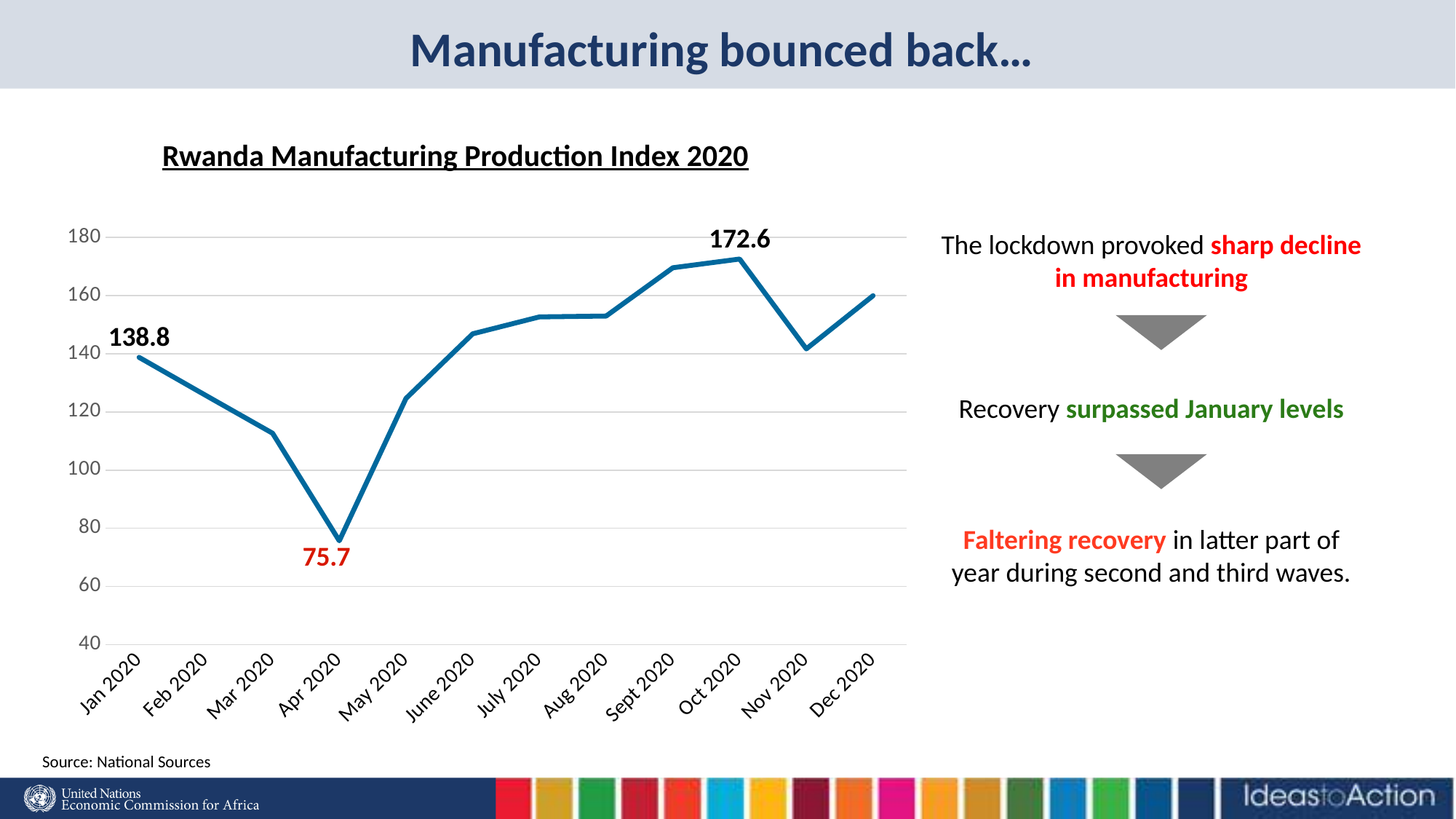
Which is larger, the value for Jan 2020 or the value for Oct 2020? Oct 2020 Which month has the highest value on the chart? Oct 2020 What is the difference between the Oct 2020 value and the Jan 2020 value? 33.8 How many months are plotted on the chart? 12 What kind of chart is shown on the slide? Line chart What is the value of the Rwanda Manufacturing Production Index for Apr 2020? 75.7 Is the value for Nov 2020 greater or less than 160? less Which month has the lowest value on the chart? Apr 2020 Does the index rise or fall from Jan 2020 to Apr 2020? Fall What is the value of the Rwanda Manufacturing Production Index for Oct 2020? 172.6 Is the value for Sept 2020 greater or less than 160? greater What is the value of the Rwanda Manufacturing Production Index for Jan 2020? 138.8